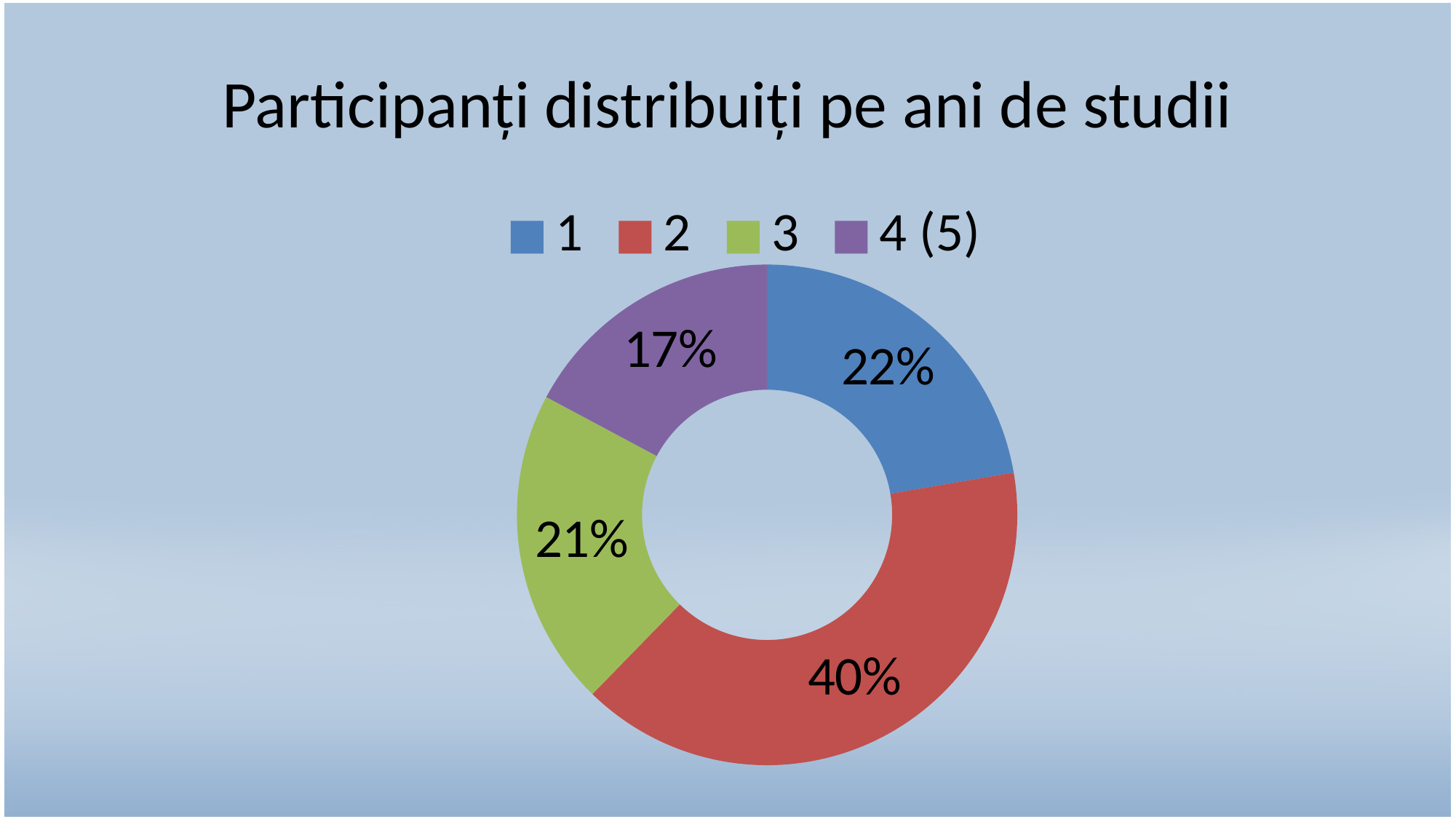
Which year of study has the largest share of participants? 2 What is the title of the chart? Participanți distribuiți pe ani de studii What is the difference in percentage points between the share for year 2 and the share for year 4 (5)? 23 What share of participants are in year 3? 21% What share of participants are in year 2? 40% What colour represents year 2 in the chart? Red What kind of chart is shown on the slide? Doughnut chart What share of participants are in year 1? 22% How many categories does the chart show? 4 Which year of study has the smallest share of participants? 4 (5) Which has a larger share of participants, year 1 or year 3? 1 What share of participants are in year 4 (5)? 17%